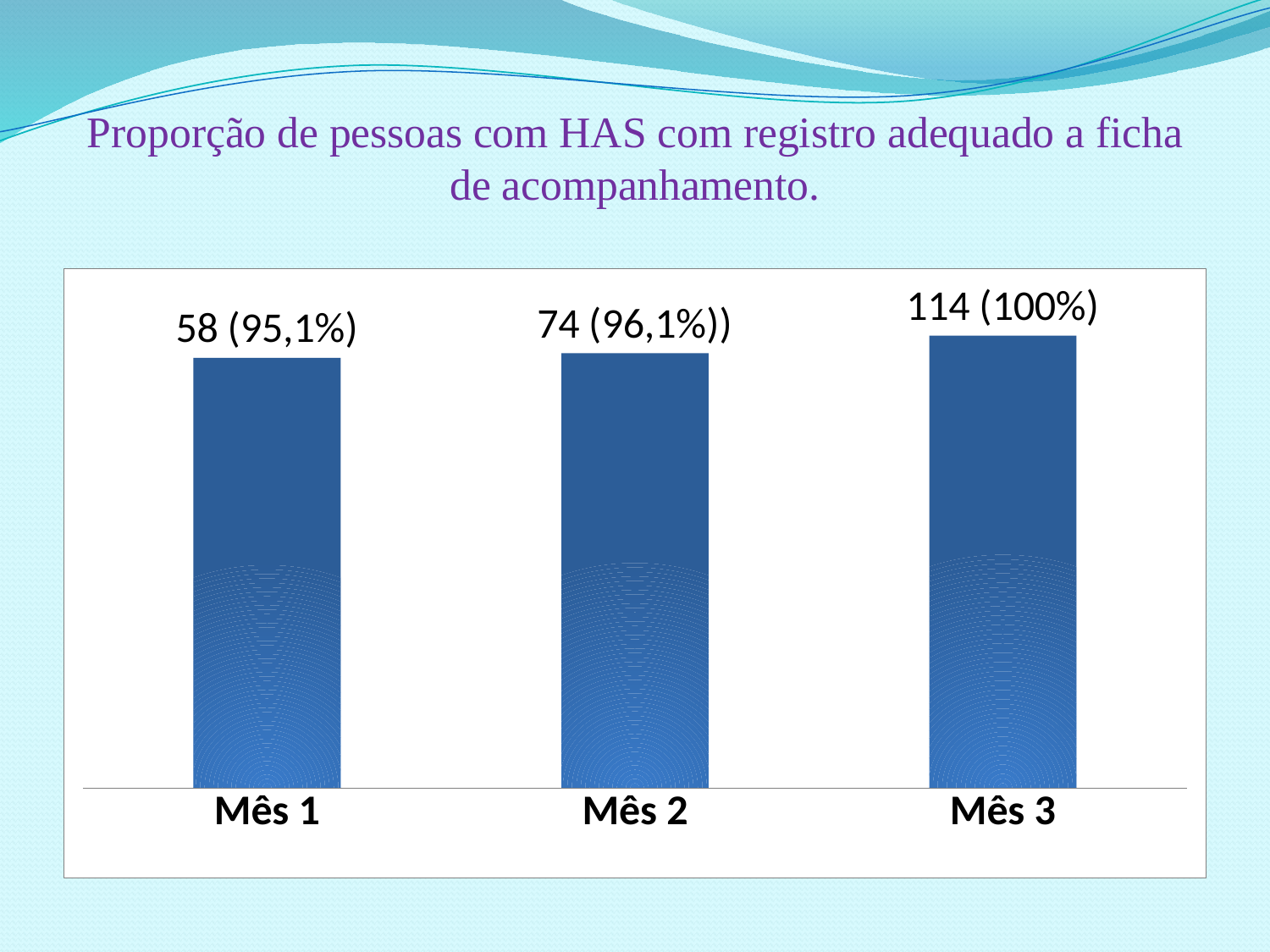
What percentage is shown for Mês 3? 100% Which month has the highest value? Mês 3 Do the values rise or fall from Mês 1 to Mês 3? Rise What kind of chart is shown on the slide? Bar chart What is the difference between the counts shown for Mês 2 and Mês 1? 16 Which month has the lowest value? Mês 1 What count is shown in the data label for Mês 2? 74 What data label is shown above the bar for Mês 1? 58 (95,1%) What is the difference between the counts shown for Mês 3 and Mês 1? 56 How many months (categories) are shown on the x axis? 3 Which has a larger count, Mês 2 or Mês 3? Mês 3 What percentage is shown in the data label for Mês 2? 96,1%